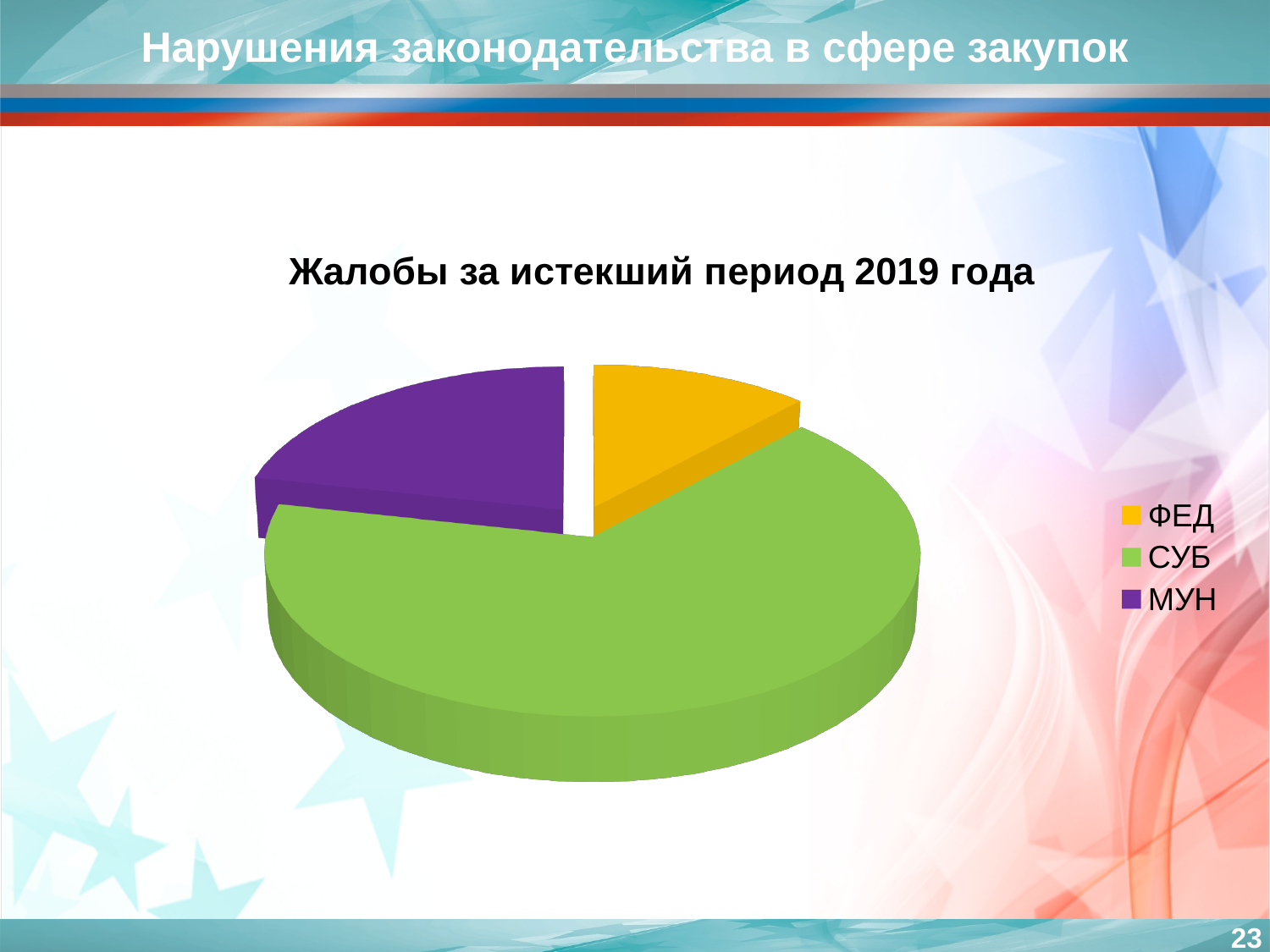
Which slice is larger, МУН or ФЕД? МУН Which slice is larger, ФЕД or СУБ? СУБ What colour is the СУБ slice in the pie chart? Green How many slices does the pie chart have? 3 Which slice is larger, СУБ or МУН? СУБ How many entries does the legend list? 3 What is the title of the chart? Жалобы за истекший период 2019 года Which category has the smallest slice of the pie? ФЕД Which category has the largest slice of the pie? СУБ What kind of chart is shown on the slide? Pie chart